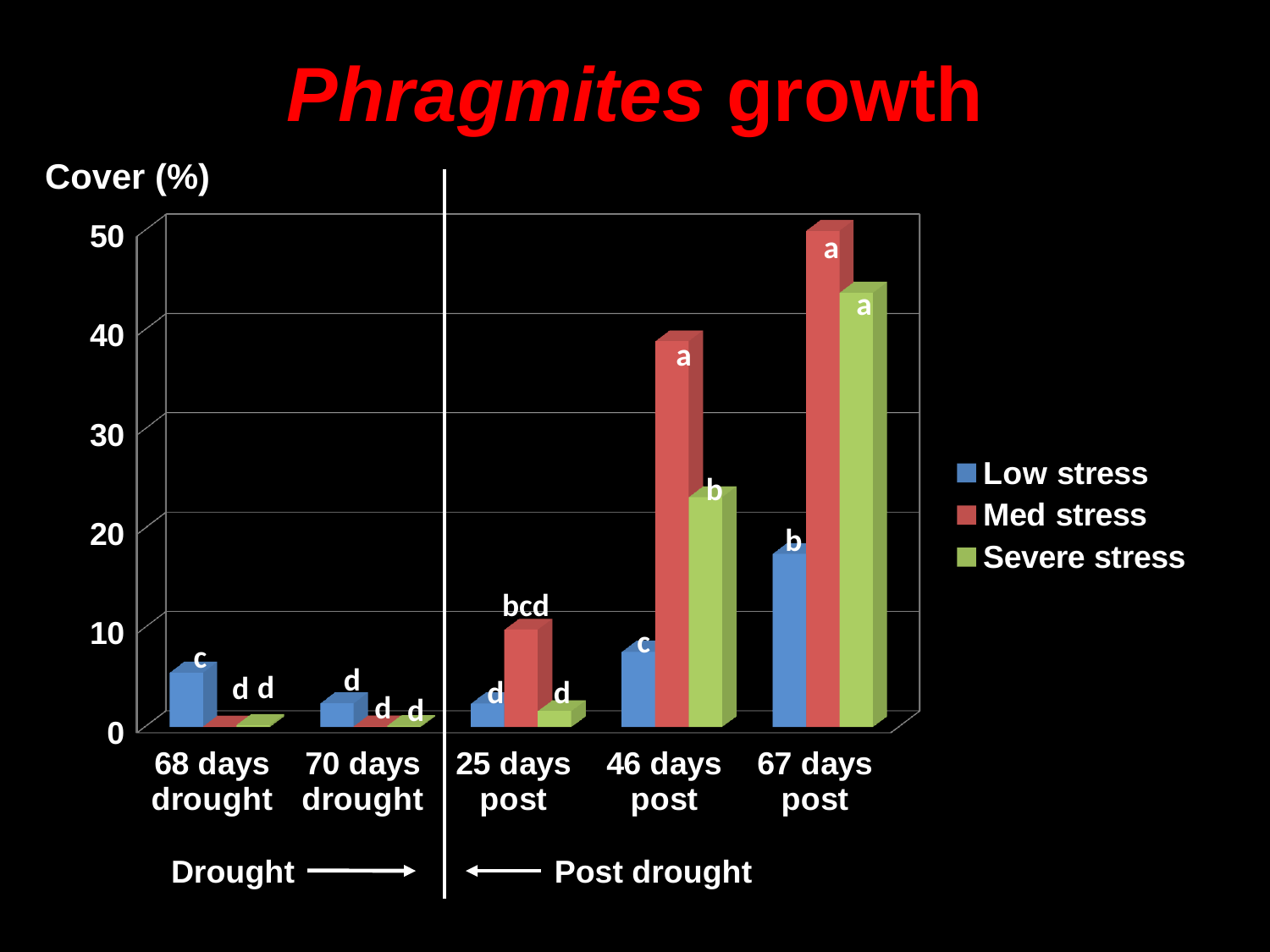
What kind of chart is shown on the slide? bar chart Is the Low stress value at 67 days post greater or less than 20? less Is the Med stress value at 67 days post greater or less than 40? greater What is the label on the y axis of the chart? Cover (%) Which series has the tallest bar at 46 days post? Med stress At 46 days post, which is larger: the Low stress bar or the Severe stress bar? Severe stress Which category has the highest Med stress bar? 67 days post How many categories are shown along the x axis? 5 Do the Med stress values rise or fall from 25 days post to 67 days post? rise Is the Low stress value at 68 days drought greater or less than 10? less How many series does the legend list? 3